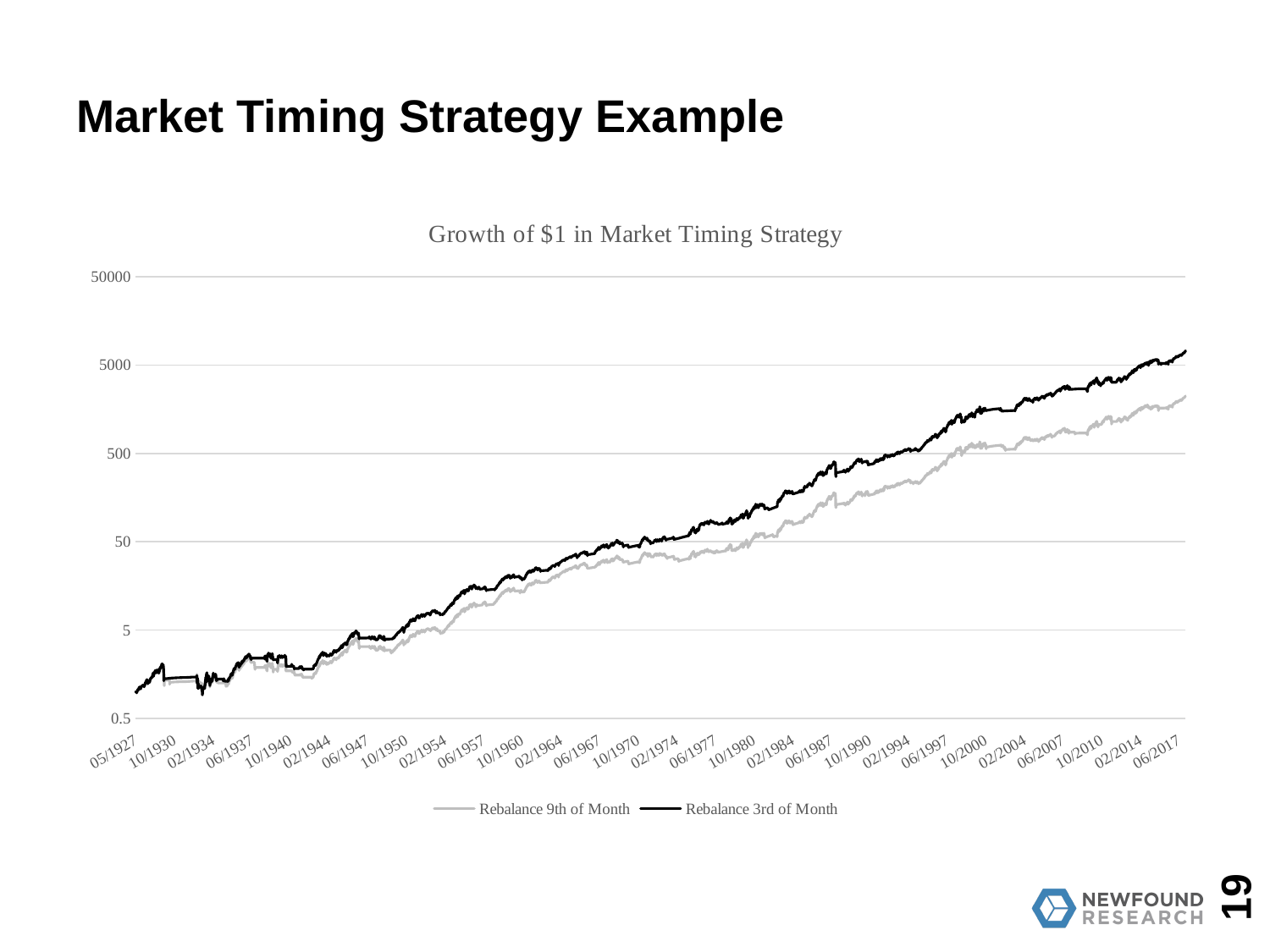
Is the value for Rebalance 3rd of Month at 06/2017 greater or less than 5000? greater What kind of chart is shown on the slide? line chart Is the value for Rebalance 3rd of Month at 05/1927 greater or less than 5? less Which series is drawn with the black line? Rebalance 3rd of Month At 06/2017, which series is higher: Rebalance 9th of Month or Rebalance 3rd of Month? Rebalance 3rd of Month Is the value for Rebalance 9th of Month at 06/1997 greater or less than 500? less What is the title of the chart? Growth of $1 in Market Timing Strategy How many series does the legend list? 2 Do the values for Rebalance 3rd of Month rise or fall overall from 05/1927 to 06/2017? rise